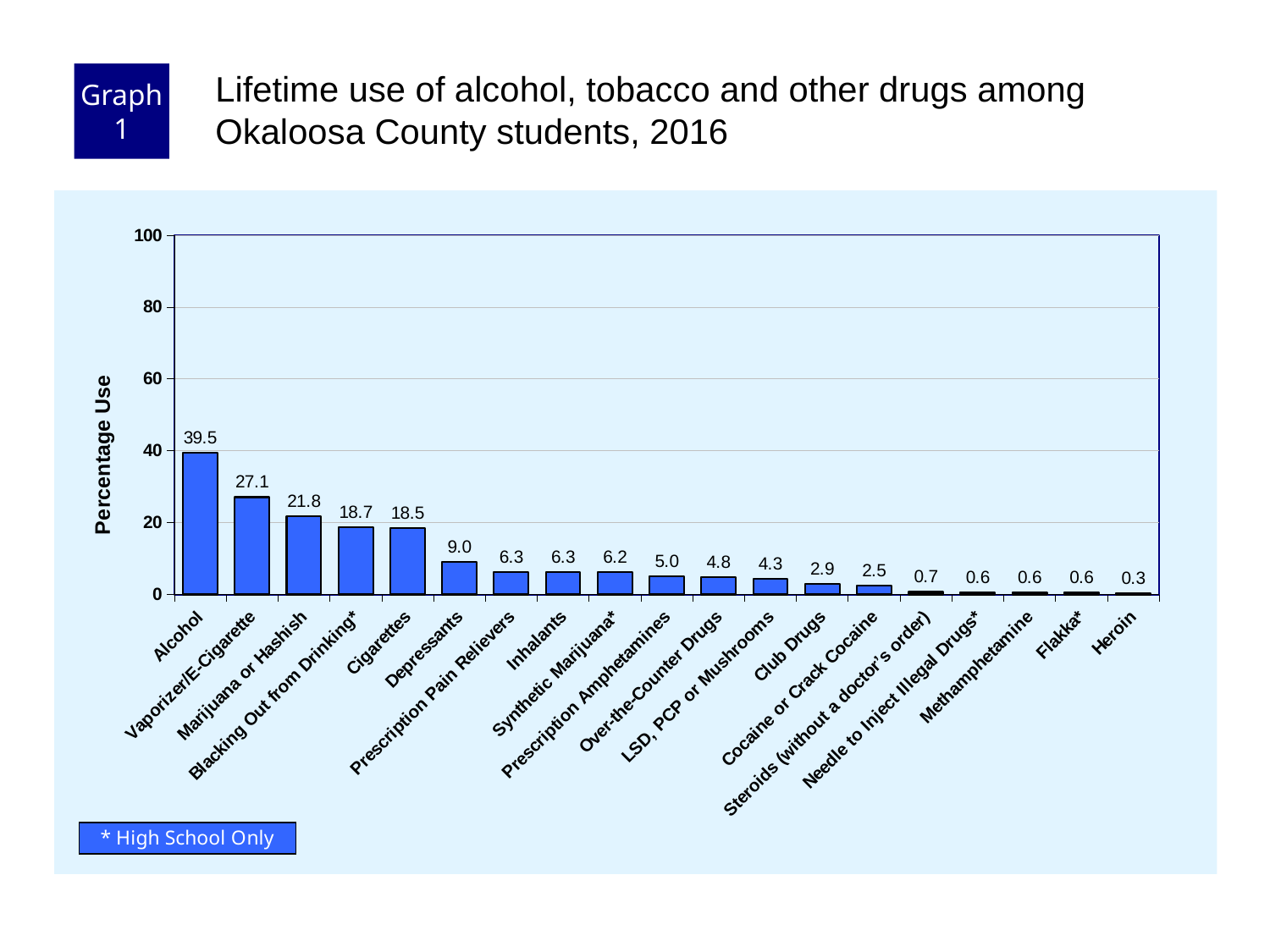
What kind of chart is shown on the slide? Bar chart Which has a higher percentage use, Marijuana or Hashish or Cigarettes? Marijuana or Hashish What is the label on the vertical axis of the chart? Percentage Use How many categories are shown on the chart? 19 What is the percentage use for Cigarettes? 18.5 What is the percentage use for Alcohol? 39.5 What is the percentage use for Heroin? 0.3 Which category has the highest percentage use? Alcohol Which category has the lowest percentage use? Heroin What is the percentage use for Vaporizer/E-Cigarette? 27.1 What is the percentage use for Depressants? 9.0 What is the difference in percentage use between Alcohol and Vaporizer/E-Cigarette? 12.4